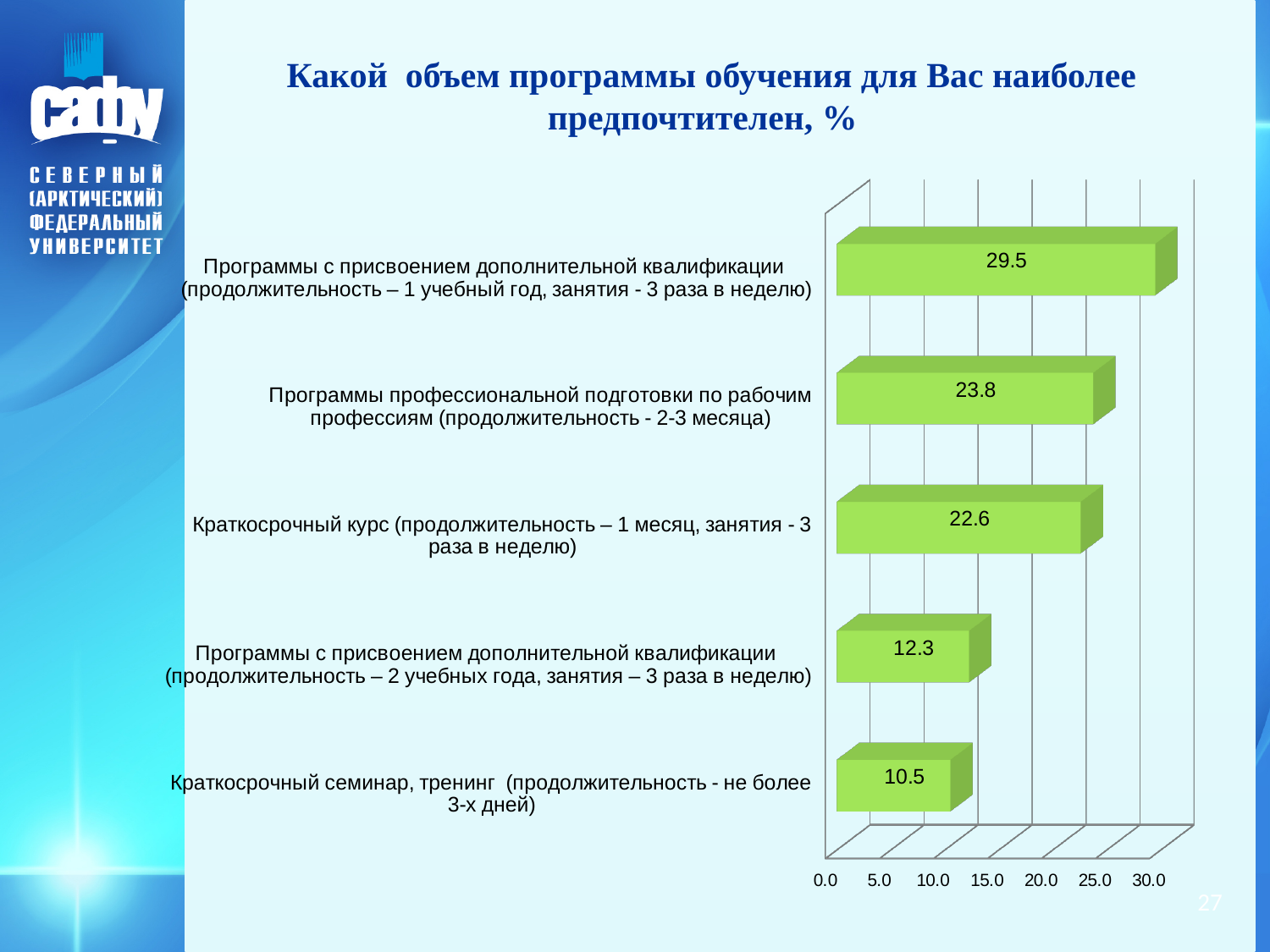
What is the value for 'Краткосрочный семинар, тренинг (продолжительность - не более 3-х дней)'? 10.5 What is the difference between the value for the one-year additional qualification programmes (29.5) and the two-year additional qualification programmes (12.3)? 17.2 Is the value for 'Программы с присвоением дополнительной квалификации (продолжительность – 2 учебных года, занятия – 3 раза в неделю)' greater or less than 15.0? less Which is larger: the value for 'Программы профессиональной подготовки по рабочим профессиям' or for 'Краткосрочный курс'? Программы профессиональной подготовки по рабочим профессиям Which category has the lowest value? Краткосрочный семинар, тренинг (продолжительность - не более 3-х дней) Which category has the highest value? Программы с присвоением дополнительной квалификации (продолжительность – 1 учебный год, занятия - 3 раза в неделю) What kind of chart is shown on the slide? bar chart How many categories are shown in the chart? 5 What is the title of the chart? Какой объем программы обучения для Вас наиболее предпочтителен, % What is the value for 'Программы профессиональной подготовки по рабочим профессиям (продолжительность - 2-3 месяца)'? 23.8 What is the value for 'Краткосрочный курс (продолжительность – 1 месяц, занятия - 3 раза в неделю)'? 22.6 What colour are the bars in the chart? green